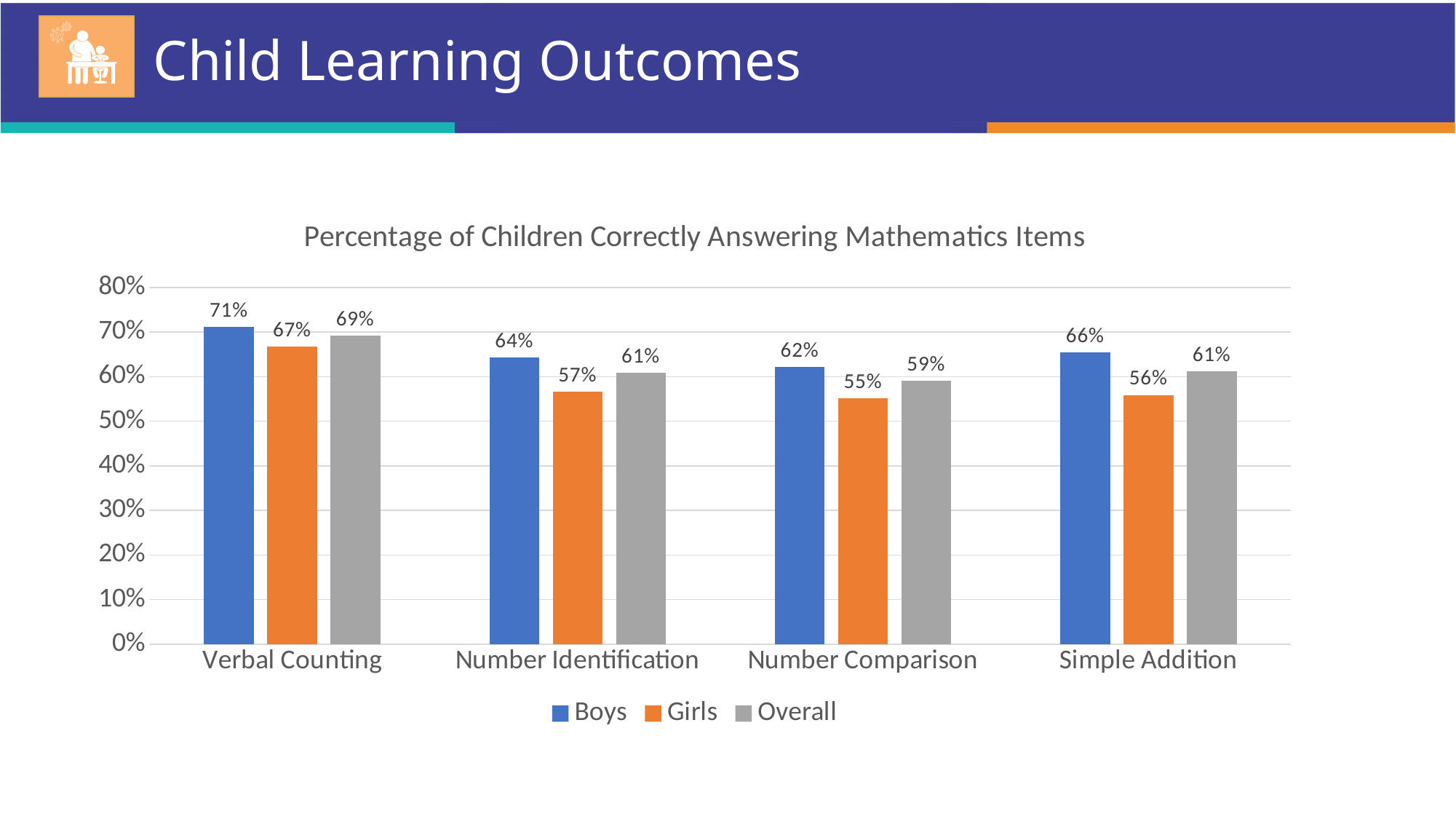
What is the title of the chart? Percentage of Children Correctly Answering Mathematics Items What kind of chart is shown on the slide? Bar chart Which mathematics item has the highest Overall percentage? Verbal Counting What percentage of boys correctly answered the Verbal Counting item? 71% How many mathematics items are shown on the x axis? 4 What is the Girls value for Number Comparison? 55% What is the difference between the Boys and Girls values for Simple Addition? 10% What is the Overall value for Simple Addition? 61% Which mathematics item has the lowest Girls percentage? Number Comparison How many series does the legend list? 3 Is the Girls value for Number Identification greater or less than 60%? less Which is larger for Number Identification, the Boys value or the Girls value? Boys